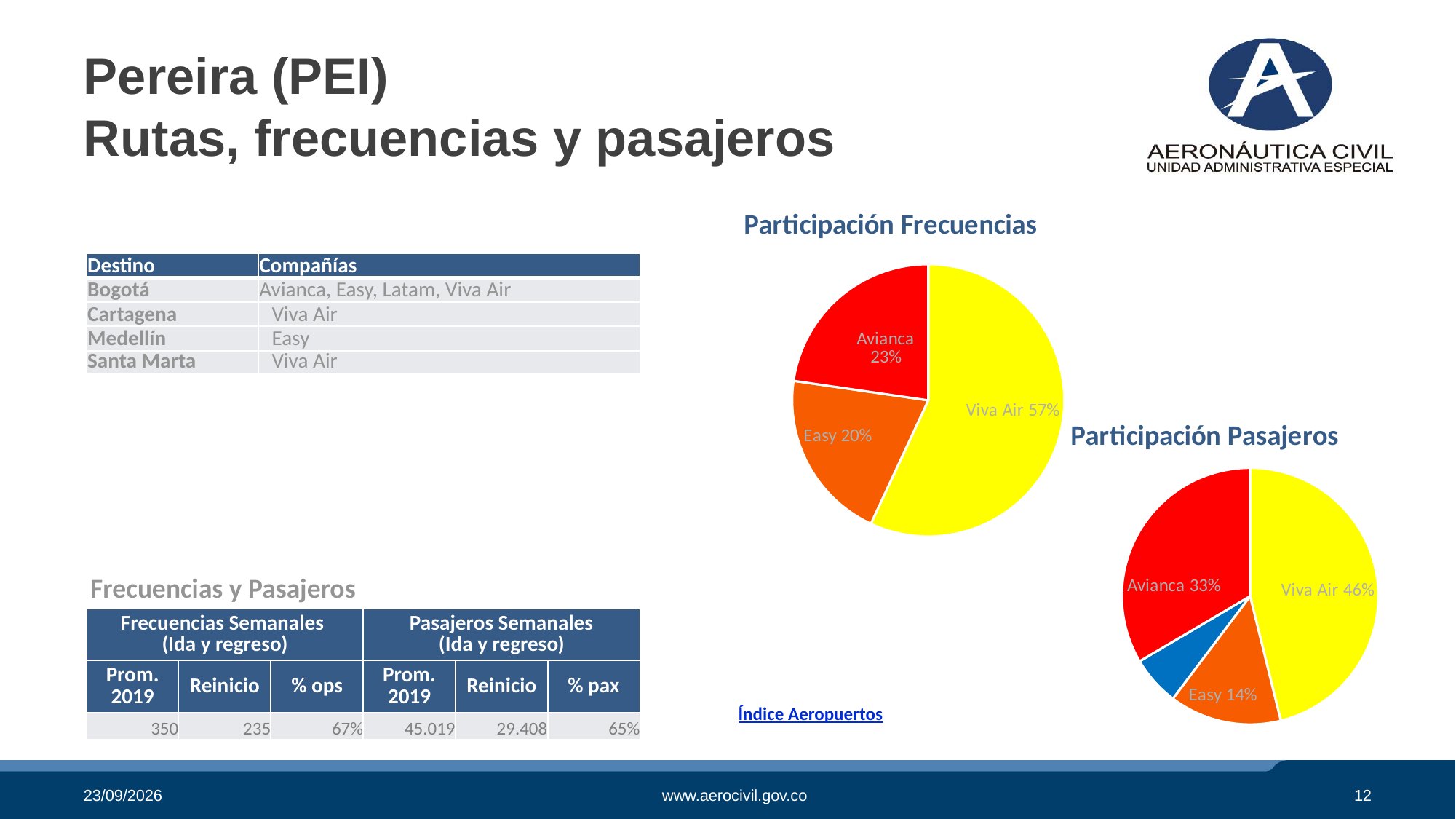
In the 'Participación Frecuencias' chart, what share does Easy have? 20% In the 'Participación Frecuencias' chart, which airline has the largest slice? Viva Air In the 'Participación Frecuencias' chart, what share does Avianca have? 23% In the 'Participación Pasajeros' chart, what share does Easy have? 14% In the 'Participación Frecuencias' chart, which airline has the smallest slice? Easy In the 'Participación Pasajeros' chart, what share does Avianca have? 33% In the 'Participación Pasajeros' chart, what share does Viva Air have? 46% In the 'Participación Pasajeros' chart, what is the difference between Avianca's share and Easy's share? 19 percentage points In the 'Participación Pasajeros' chart, which is larger, Avianca's share or Easy's share? Avianca In the 'Participación Frecuencias' chart, what share does Viva Air have? 57% In the 'Participación Frecuencias' chart, what is the difference between Viva Air's share and Avianca's share? 34 percentage points What type of chart is 'Participación Frecuencias'? Pie chart